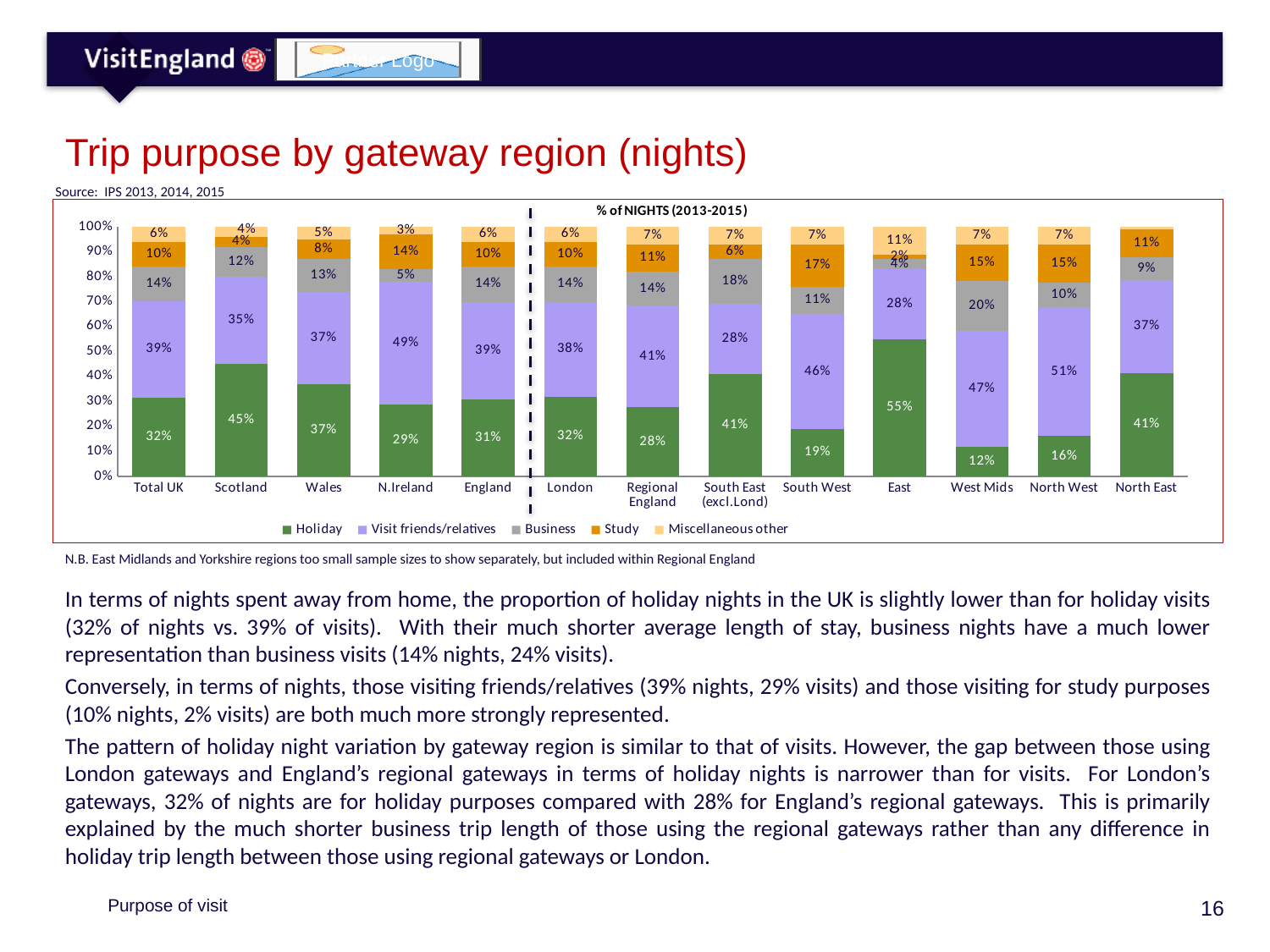
Which gateway region has the highest Holiday share of nights? East How many gateway regions (categories) are shown on the x axis of the chart? 13 Which has a larger Visit friends/relatives share of nights, North West or South East (excl.Lond)? North West What is the Study share of nights for South West? 17% What is the difference in Holiday share of nights between London and Regional England? 4% What is the Business share of nights for West Mids? 20% Which gateway region has the lowest Holiday share of nights? West Mids What is the title shown inside the chart area? % of NIGHTS (2013-2015) How many series does the chart legend list? 5 What is the Holiday share of nights for Total UK? 32% What type of chart is shown on the slide? Stacked bar chart What is the Visit friends/relatives share of nights for N.Ireland? 49%